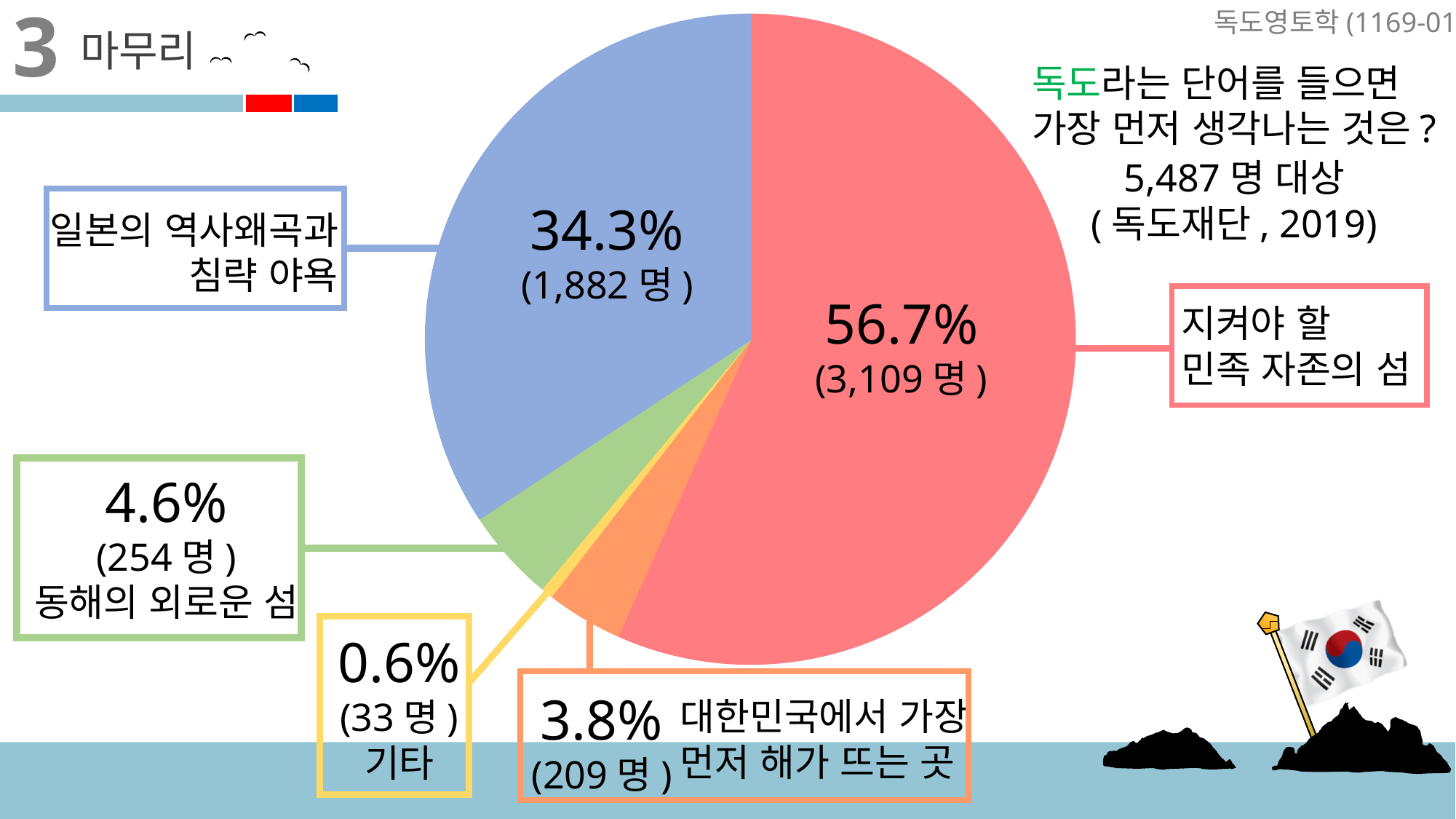
What kind of chart is shown on the slide? pie chart How many people in total were surveyed according to the slide? 5,487 명 What percentage of the pie is labelled '동해의 외로운 섬'? 4.6% Which category has the smallest share of the pie? 기타 How many respondents (명) chose '대한민국에서 가장 먼저 해가 뜨는 곳'? 209 명 What percentage of the pie is labelled '기타'? 0.6% How many respondents (명) chose '일본의 역사왜곡과 침략 야욕'? 1,882 명 What percentage of the pie is labelled '지켜야 할 민족 자존의 섬'? 56.7% How many slices does the pie chart have? 5 What is the difference in percentage points between '지켜야 할 민족 자존의 섬' and '일본의 역사왜곡과 침략 야욕'? 22.4 Which has more respondents: '동해의 외로운 섬' or '대한민국에서 가장 먼저 해가 뜨는 곳'? 동해의 외로운 섬 Which category has the largest share of the pie? 지켜야 할 민족 자존의 섬